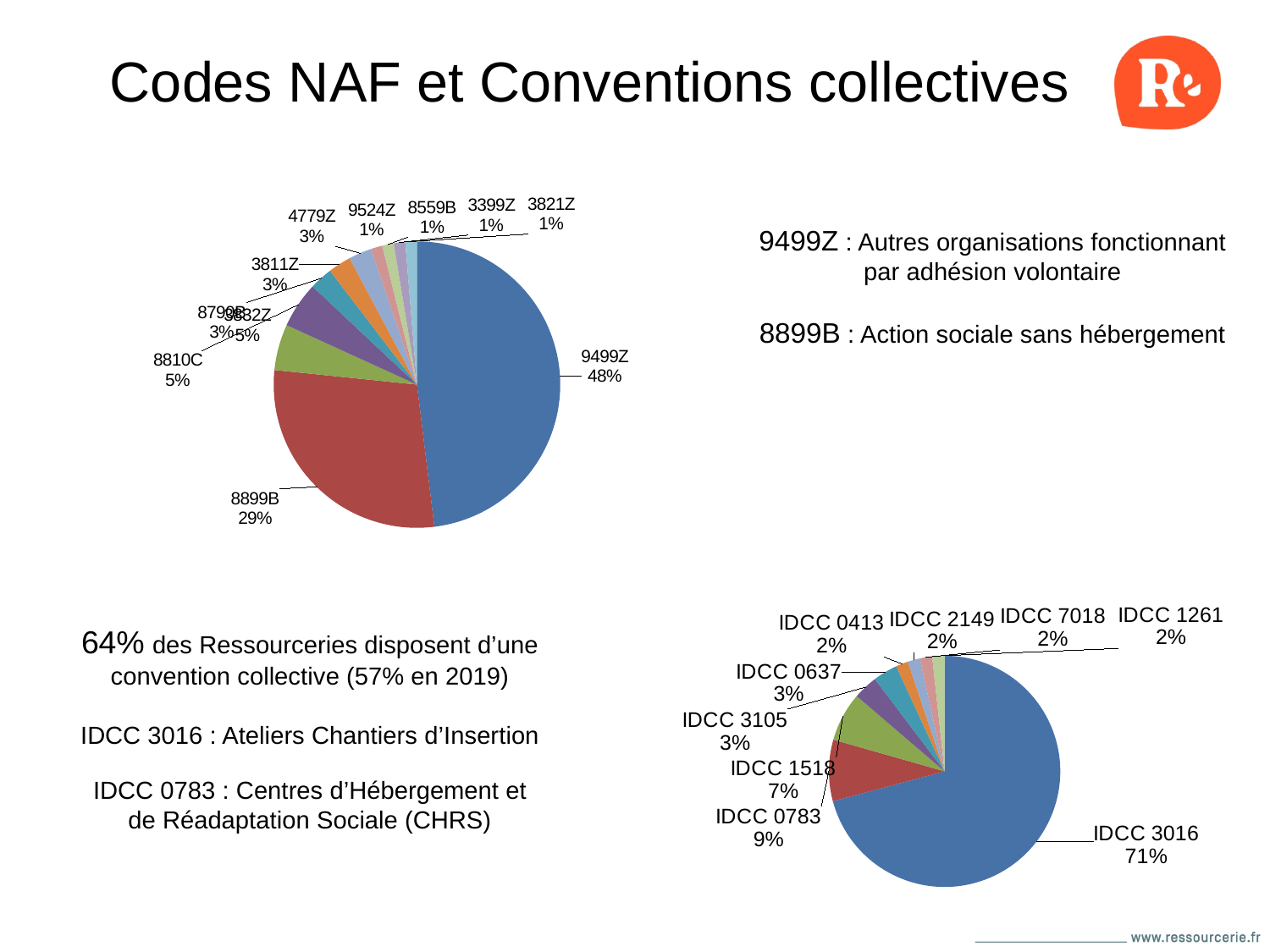
In the top-left pie chart, what share does 9499Z have? 48% In the top-left pie chart, what is the difference between the shares of 9499Z and 8899B? 19% In the top-left pie chart, what share does 8810C have? 5% In the bottom-right pie chart, what is the difference between the shares of IDCC 0783 and IDCC 1518? 2% In the bottom-right pie chart, which is larger, the share of IDCC 1518 or the share of IDCC 3105? IDCC 1518 What kind of chart is shown in the bottom-right of the slide? Pie chart In the bottom-right pie chart, how many categories are shown? 9 In the top-left pie chart, which category has the largest slice? 9499Z In the bottom-right pie chart, what share does IDCC 0783 have? 9% In the top-left pie chart, what share does 8899B have? 29% In the bottom-right pie chart, what share does IDCC 3016 have? 71% In the top-left pie chart, which is larger, the share of 4779Z or the share of 8810C? 8810C